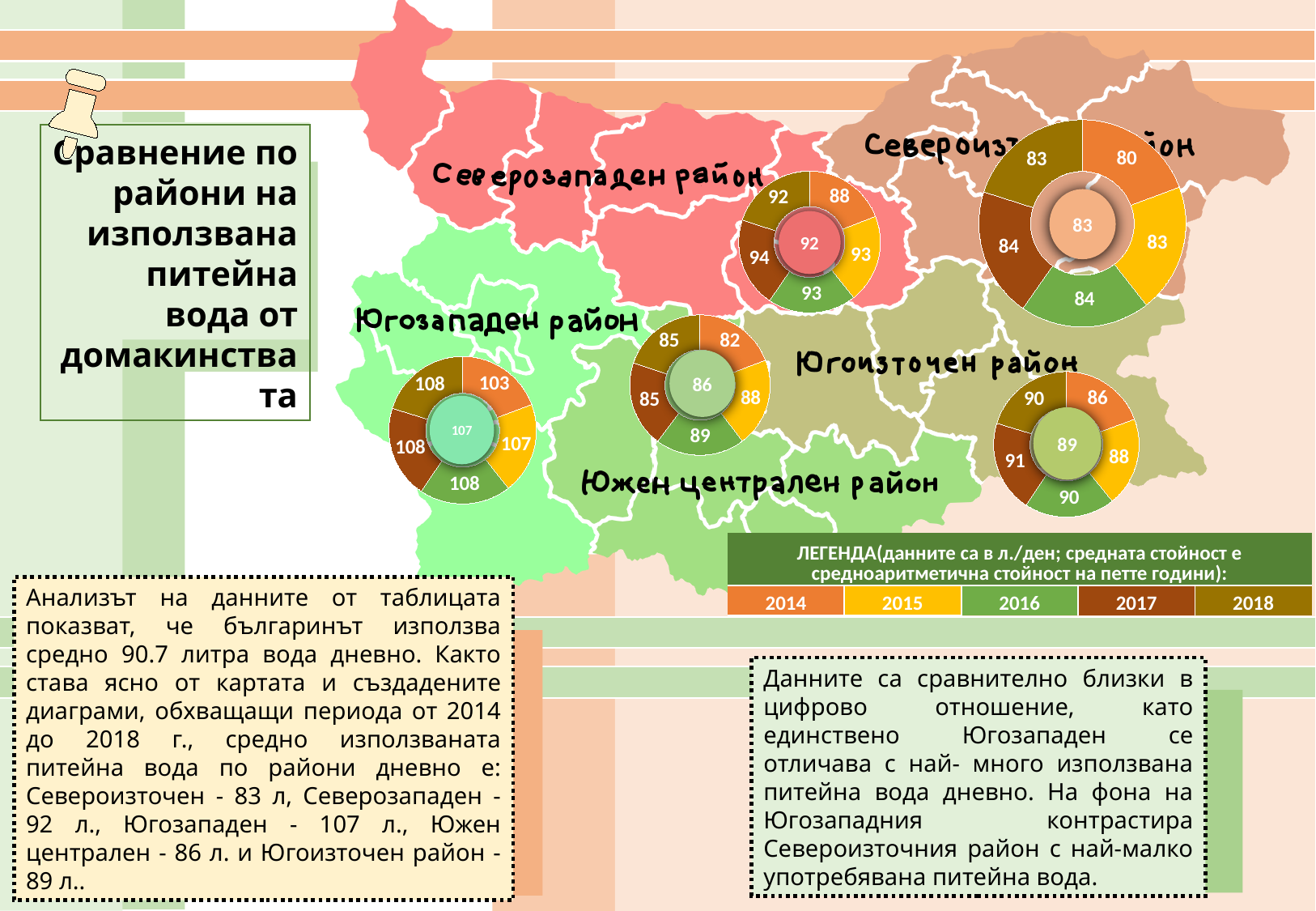
In the doughnut chart for Югозападен район, what is the value for 2015? 107 In the doughnut chart for Южен централен район, what is the value for 2017? 85 In the doughnut chart for Югоизточен район, which year has the lowest value? 2014 In the doughnut chart for Югоизточен район, what is the average value shown in the centre? 89 In the doughnut chart for Югозападен район, what is the difference between the 2016 value and the 2014 value? 5 In the doughnut chart for Северозападен район, what is the value for 2014? 88 In the doughnut chart for Североизточен район, what is the value for 2016? 84 What kind of chart is used for each region on the map? Doughnut chart According to the legend, which colour represents 2015? Yellow Comparing the centre averages, which region's chart shows a larger value: Югозападен район or Североизточен район? Югозападен район In the doughnut chart for Северозападен район, which year has the highest value? 2017 How many years does the legend list for the charts? 5